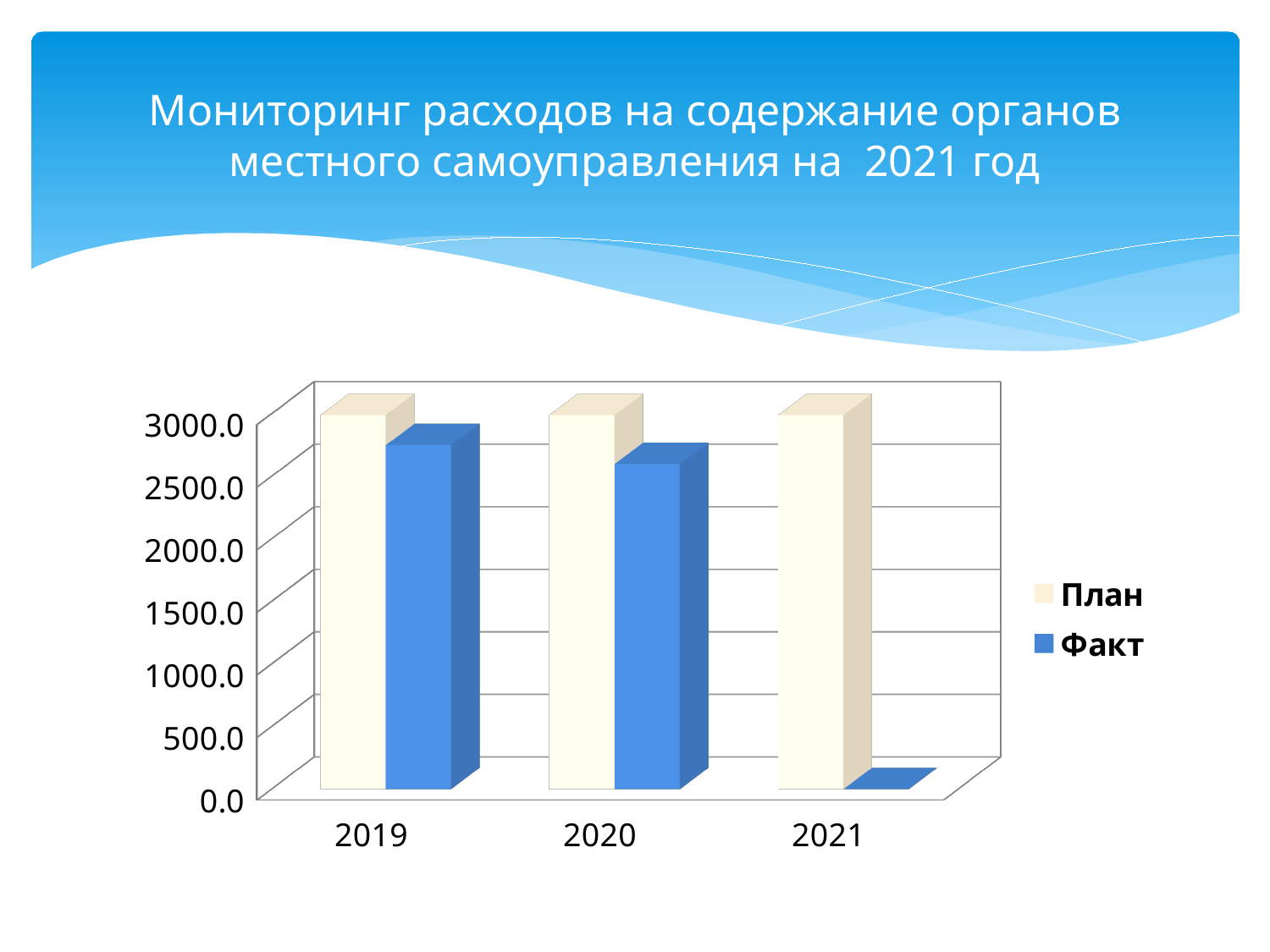
Which series is shown in blue? Факт Is the План value for 2020 greater or less than 2500? greater Which is larger, the Факт value for 2019 or the Факт value for 2020? 2019 Is the Факт value for 2021 greater or less than 500? less Which year has the highest Факт value? 2019 Do the Факт values rise or fall from 2019 to 2021? fall Which year has the lowest Факт value? 2021 What kind of chart is shown on the slide? bar chart Is the Факт value for 2019 greater or less than 2500? greater Which series are listed in the legend? План, Факт How many years are shown on the x axis? 3 How many series does the legend list? 2